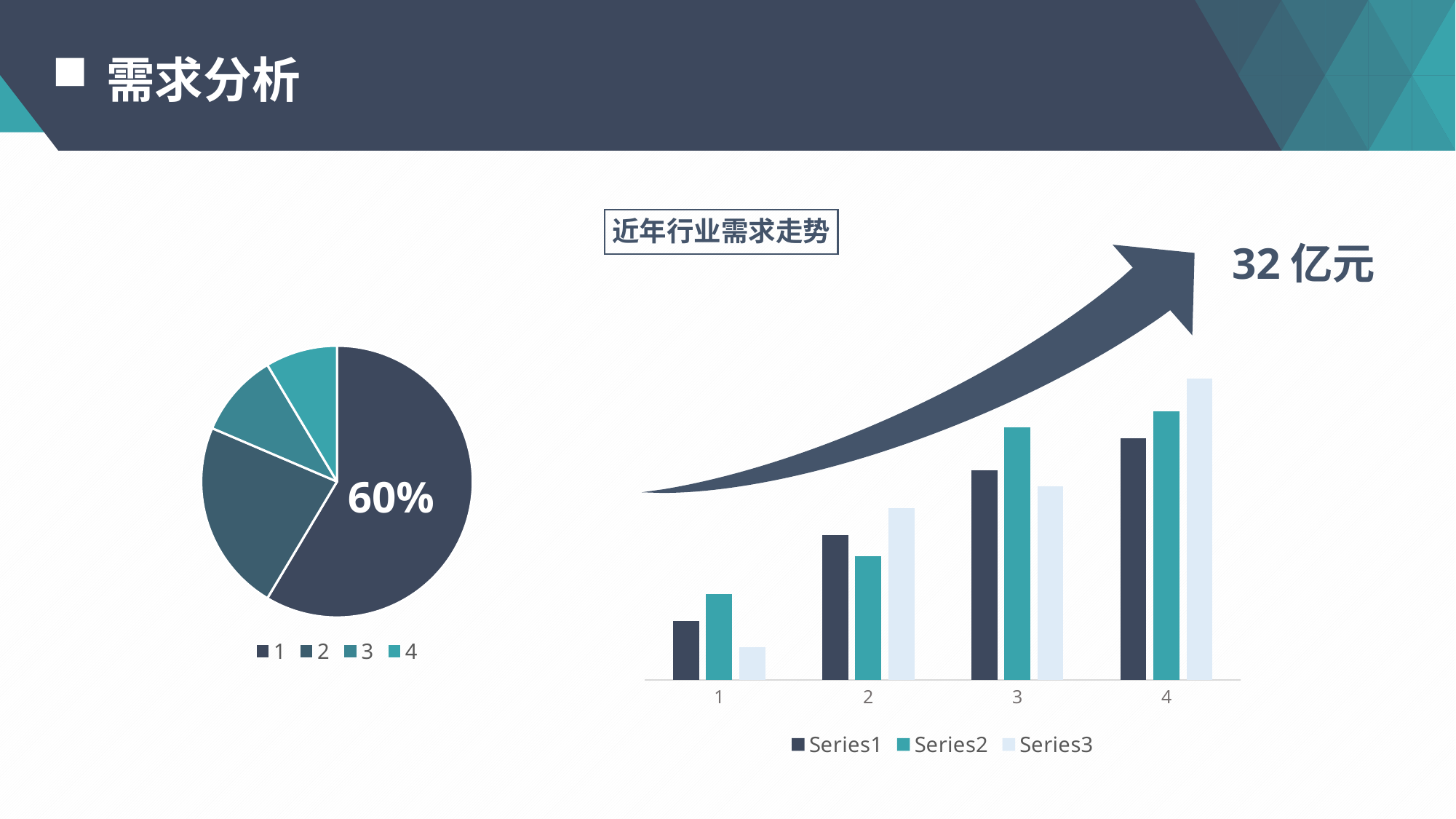
How many categories are shown on the x axis of the chart titled 近年行业需求走势? 4 In the pie chart on the left, which slice is the smallest? 4 What kind of chart is the chart on the left of the slide? pie chart In the chart titled 近年行业需求走势, do the Series1 values rise or fall from category 1 to category 4? rise In the pie chart on the left, which slice is the largest? 1 How many slices does the pie chart on the left have? 4 In the chart titled 近年行业需求走势, which category has the highest Series3 value? 4 In the chart titled 近年行业需求走势, at category 2, which is larger, Series1 or Series2? Series1 What kind of chart is the chart titled 近年行业需求走势? bar chart In the pie chart on the left, which slice is larger, 2 or 3? 2 How many series does the legend of the chart titled 近年行业需求走势 list? 3 In the pie chart on the left, what share of the pie does slice 1 take? 60%